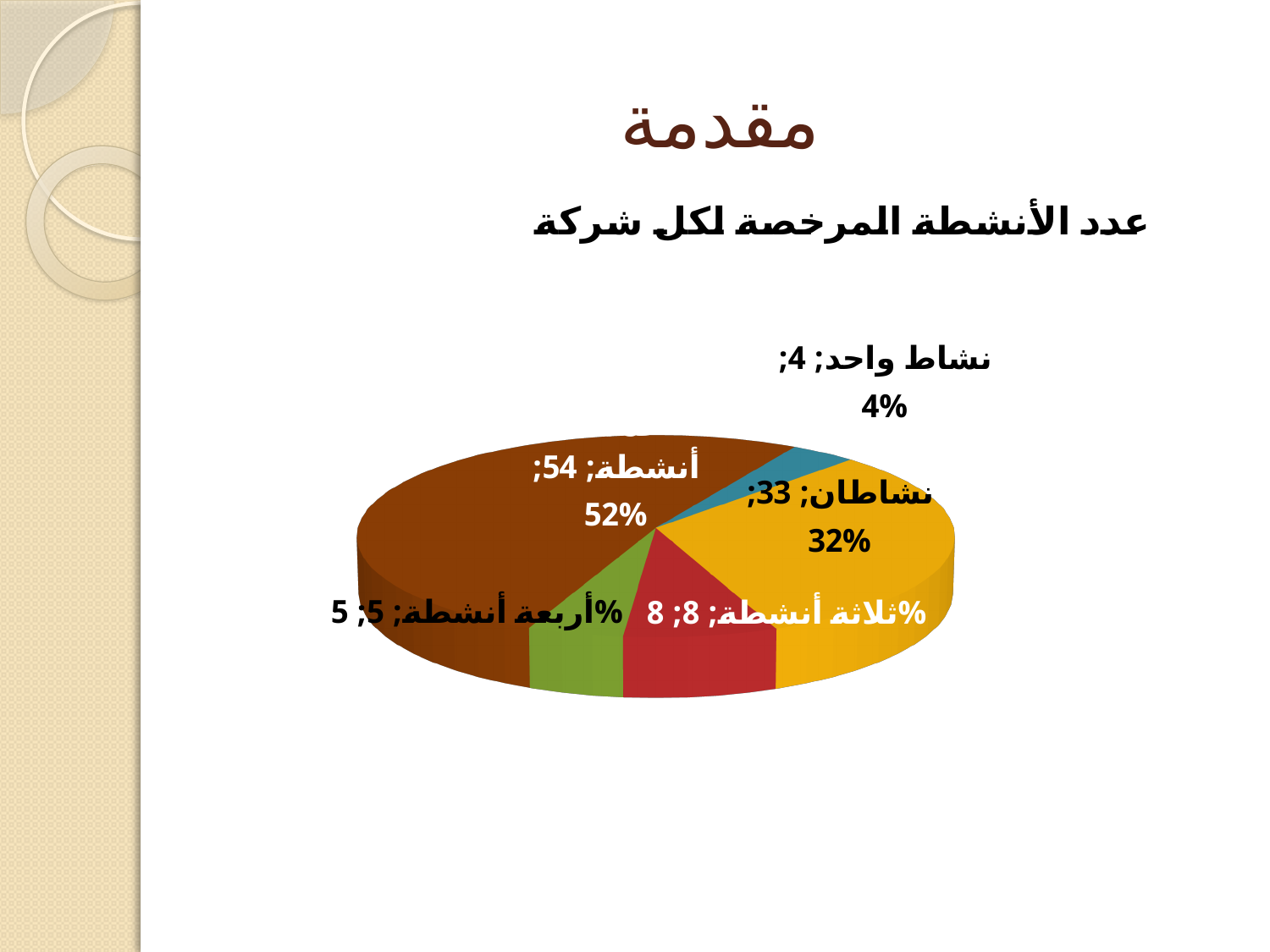
Which is larger, the value for ثلاثة أنشطة or the value for أربعة أنشطة? ثلاثة أنشطة What percentage share of the pie does نشاطان have? 32% How many slices does the pie chart have? 5 What is the value for ثلاثة أنشطة? 8 What is the difference between the values for نشاطان and ثلاثة أنشطة? 25 What is the title of the chart? عدد الأنشطة المرخصة لكل شركة What kind of chart is shown on the slide? pie chart Which category has the smallest value? نشاط واحد What is the value for نشاط واحد? 4 What percentage share of the pie does the largest (brown) slice have? 52% What is the value for نشاطان? 33 What is the value for أربعة أنشطة? 5